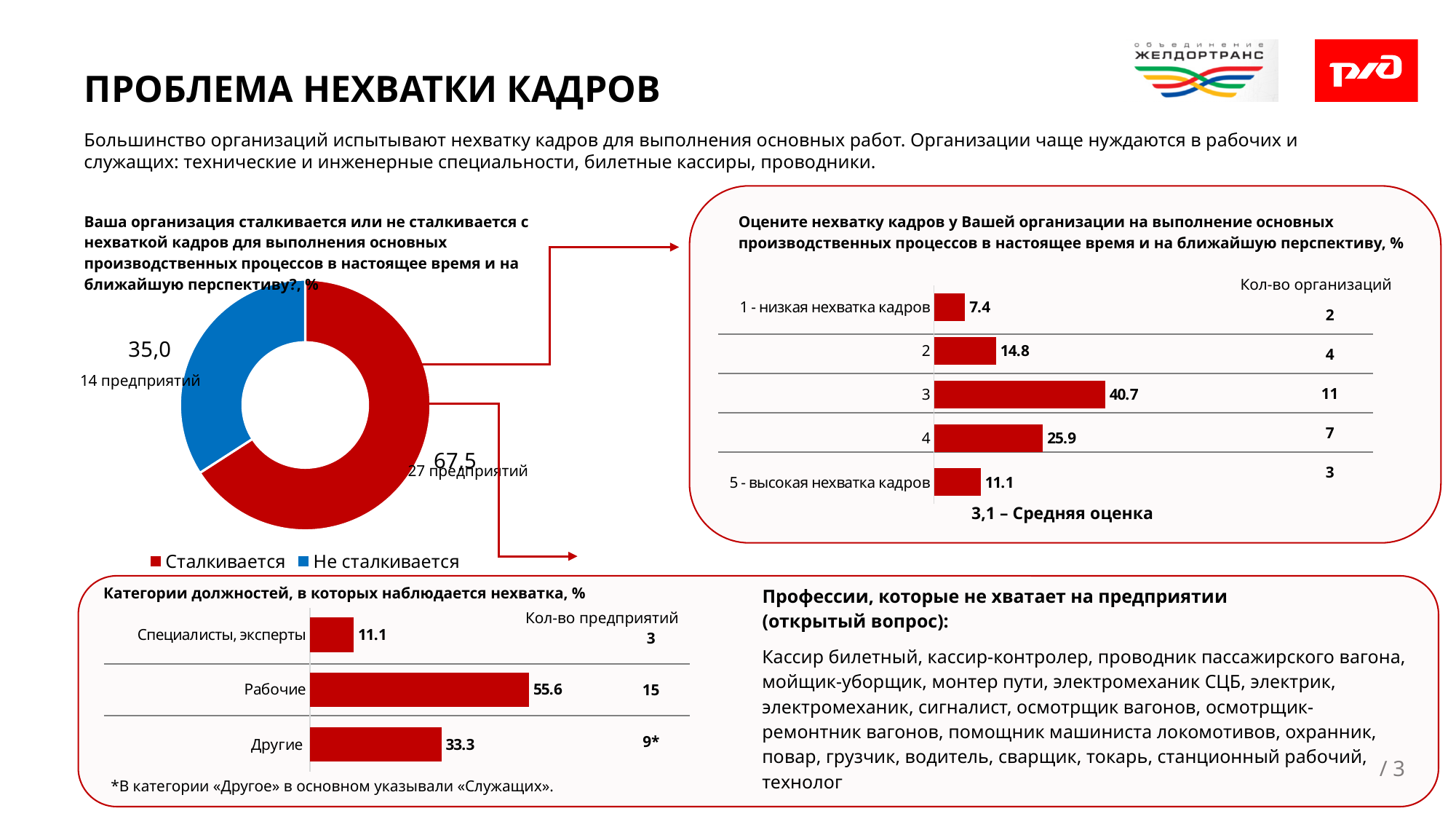
In the donut chart on the left, what value is shown for «Сталкивается»? 67,5 In the chart «Категории должностей, в которых наблюдается нехватка, %», what is the value for «Рабочие»? 55.6 How many entries does the legend of the donut chart on the left list? 2 In the chart «Оцените нехватку кадров у Вашей организации...», which rating has the lowest value? 1 - низкая нехватка кадров How many categories are shown in the chart «Оцените нехватку кадров у Вашей организации...»? 5 In the donut chart on the left, what value is shown for «Не сталкивается»? 35,0 In the chart «Оцените нехватку кадров у Вашей организации...», what is the difference between the values for rating 3 and rating 4? 14.8 In the chart «Оцените нехватку кадров у Вашей организации...», which rating has the highest value? 3 In the chart «Оцените нехватку кадров у Вашей организации...», what is the value for rating 3? 40.7 In the chart «Категории должностей, в которых наблюдается нехватка, %», what is the difference between «Рабочие» and «Другие»? 22.3 In the chart «Категории должностей, в которых наблюдается нехватка, %», which category has the highest value? Рабочие What kind of chart is the chart on the left of the slide? Donut (pie) chart